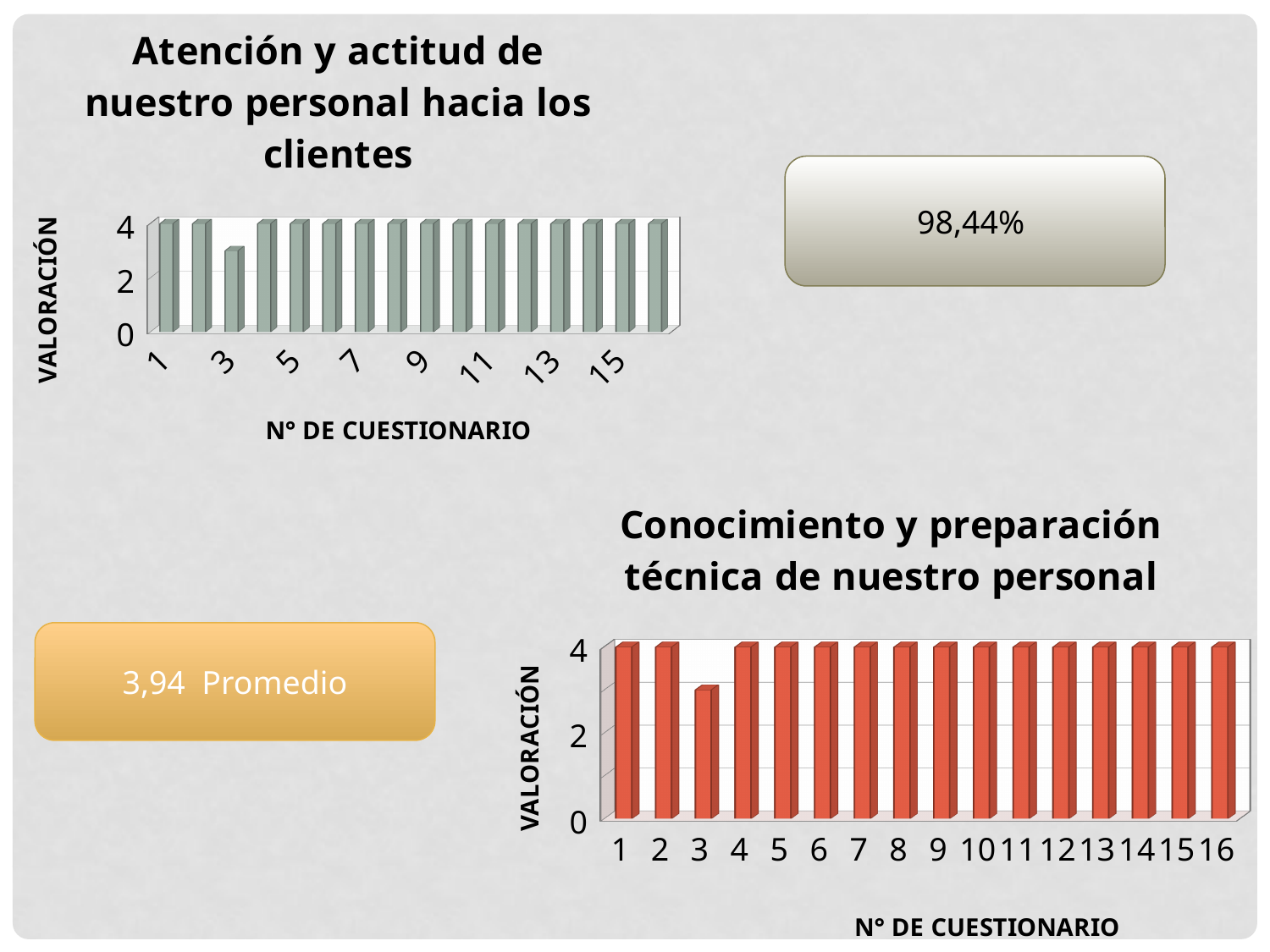
In the 'Conocimiento y preparación técnica de nuestro personal' chart, which has the larger valoración, questionnaire 2 or questionnaire 3? questionnaire 2 In the 'Conocimiento y preparación técnica de nuestro personal' chart, what is the valoración for questionnaire 1? 4 In the 'Atención y actitud de nuestro personal hacia los clientes' chart, what is the valoración for questionnaire 1? 4 What is the horizontal axis title of the 'Atención y actitud de nuestro personal hacia los clientes' chart? N° DE CUESTIONARIO In the 'Conocimiento y preparación técnica de nuestro personal' chart, is the value for questionnaire 3 greater or less than 2? greater What is the vertical axis title of the 'Conocimiento y preparación técnica de nuestro personal' chart? VALORACIÓN In the 'Conocimiento y preparación técnica de nuestro personal' chart, what is the valoración for questionnaire 16? 4 In the 'Atención y actitud de nuestro personal hacia los clientes' chart, which questionnaire number has the lowest valoración? 3 What kind of chart is the 'Conocimiento y preparación técnica de nuestro personal' chart? bar chart In the 'Conocimiento y preparación técnica de nuestro personal' chart, which questionnaire number has the lowest valoración? 3 In the 'Atención y actitud de nuestro personal hacia los clientes' chart, is the value for questionnaire 3 greater or less than 2? greater How many questionnaires are plotted in the 'Conocimiento y preparación técnica de nuestro personal' chart? 16